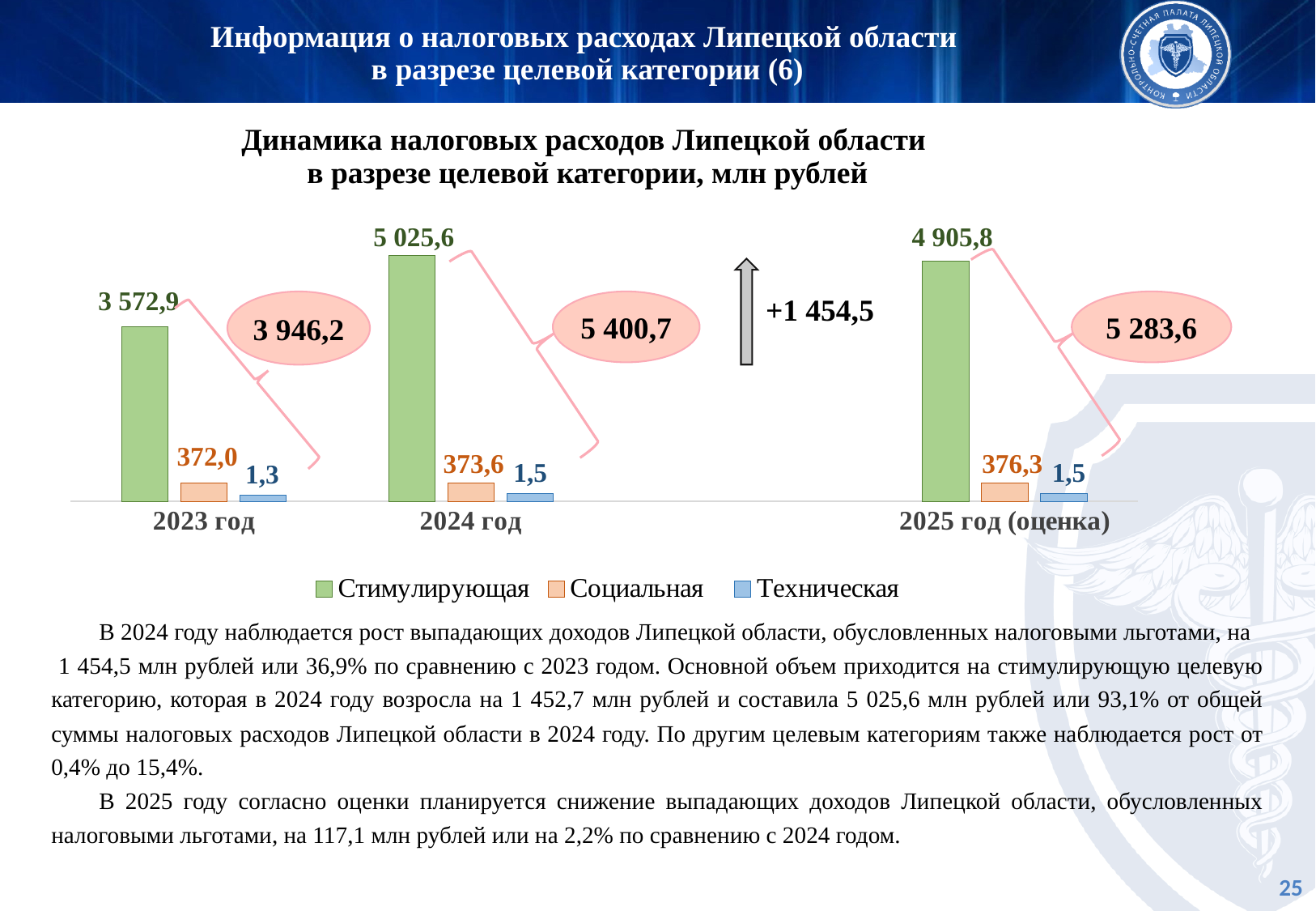
What kind of chart is shown on the slide? Bar chart Which is larger: the Социальная value for 2024 год or for 2025 год (оценка)? 2025 год (оценка) In which year is the Стимулирующая series highest? 2024 год How many year categories are shown on the x axis? 3 What is the difference between the Стимулирующая values for 2024 год and 2023 год? 1 452,7 What is the value of the Социальная series for 2025 год (оценка)? 376,3 What is the value of the Социальная series for 2023 год? 372,0 How many series does the legend list? 3 What is the value of the Техническая series for 2025 год (оценка)? 1,5 What total is shown in the oval for 2024 год? 5 400,7 In which year is the Стимулирующая series lowest? 2023 год What is the value of the Стимулирующая series for 2024 год? 5 025,6